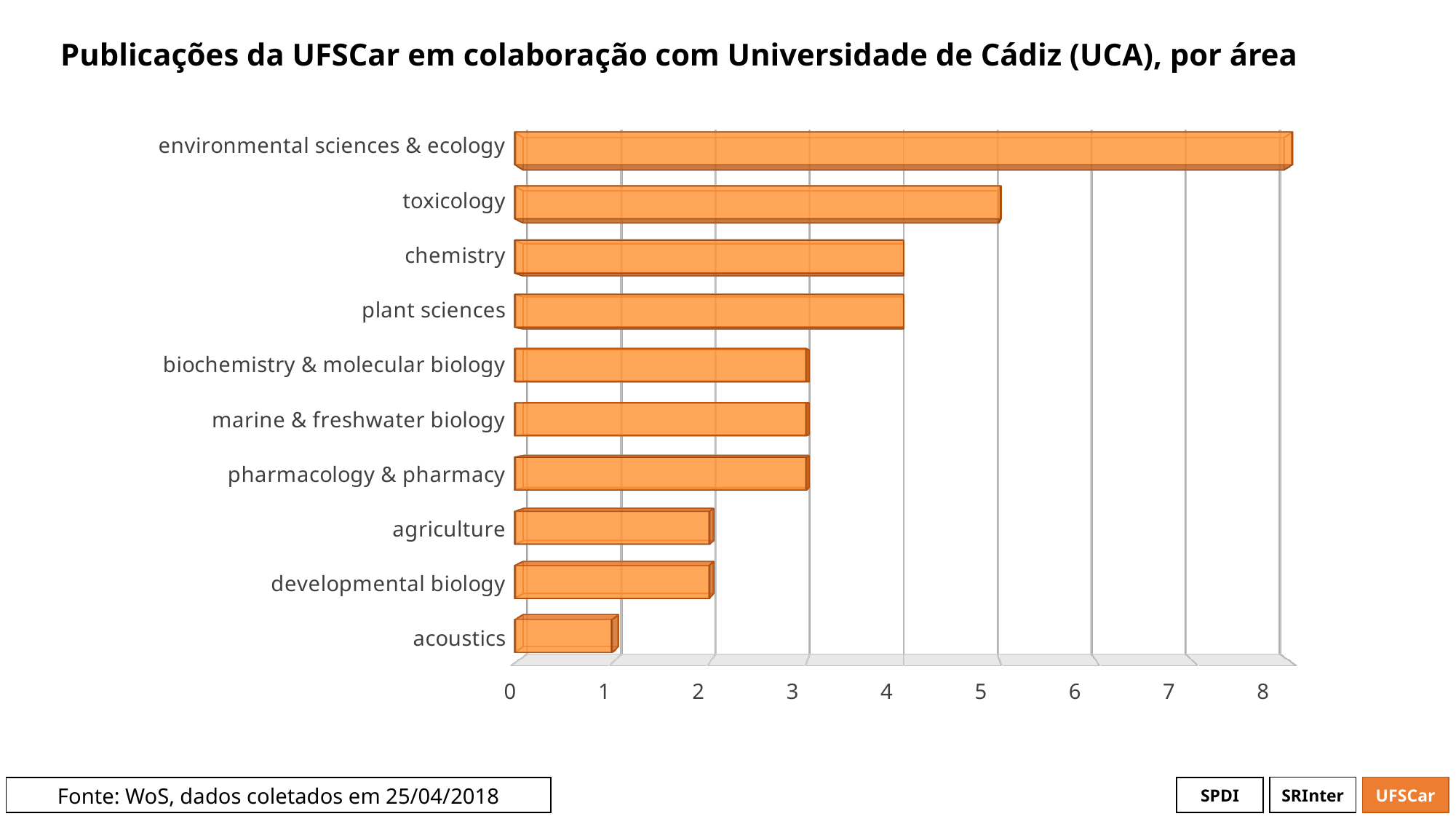
Which area has the highest number of publications? environmental sciences & ecology Which area has the lowest number of publications? acoustics What kind of chart is shown on the slide? bar chart Is the value for environmental sciences & ecology greater or less than 7? greater What is the value for toxicology? 5 Which is larger, the value for toxicology or the value for plant sciences? toxicology How many areas (categories) are plotted in the chart? 10 What is the value for chemistry? 4 What is the value for agriculture? 2 What is the difference between the values for toxicology and acoustics? 4 What is the value for acoustics? 1 What is the title of the chart? Publicações da UFSCar em colaboração com Universidade de Cádiz (UCA), por área